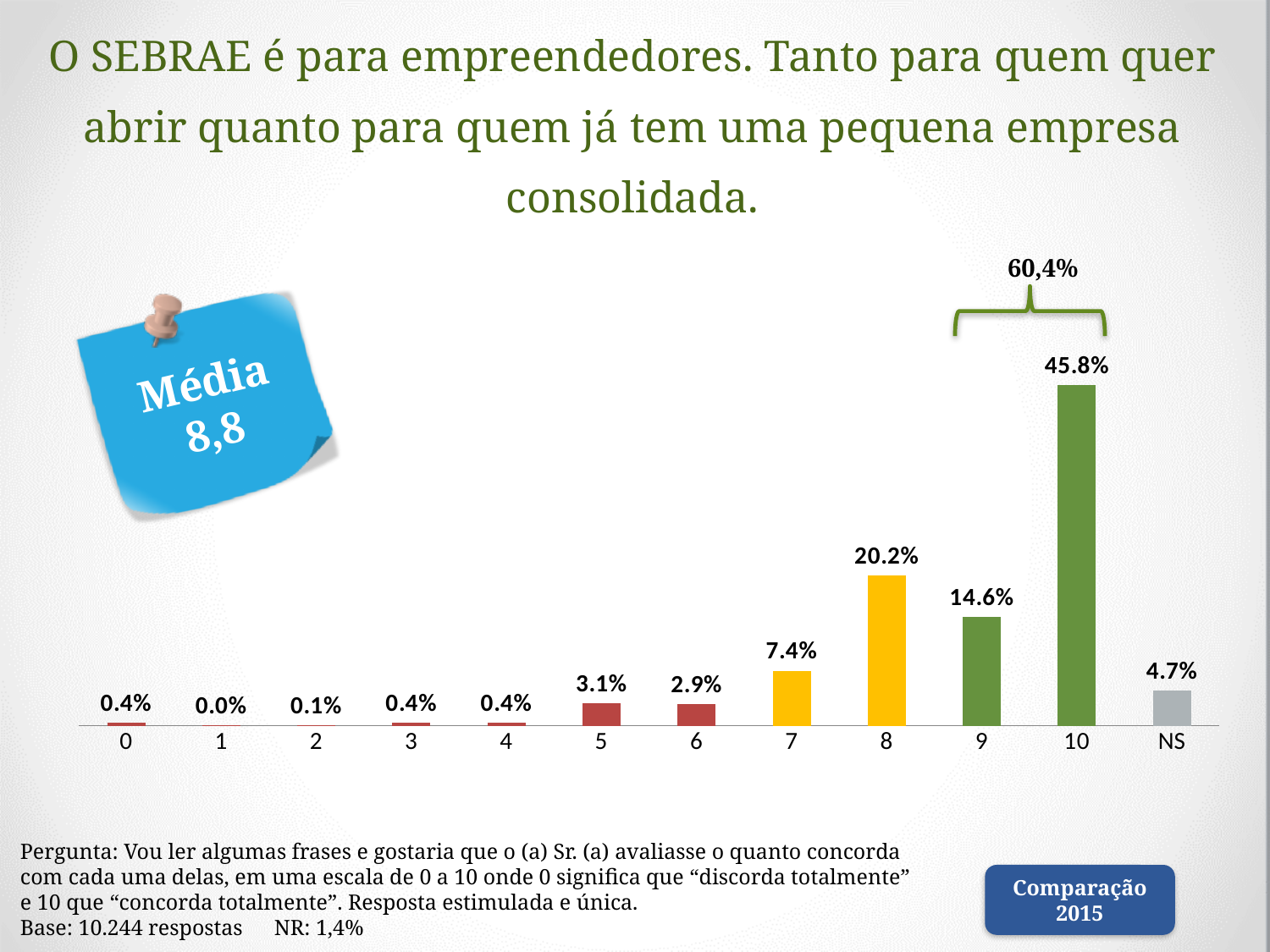
How many categories are shown on the x axis of the chart? 12 What average (Média) is shown on the note in the chart? 8,8 What is the value shown for the NS category? 4.7% Which score category has the lowest percentage? 1 Which is larger, the percentage for score 8 or for score 9? 8 Which score category has the highest percentage? 10 What kind of chart is shown on the slide? bar chart What percentage of respondents gave a score of 10? 45.8% What combined percentage is shown by the bracket above scores 9 and 10? 60,4% What is the difference between the percentages for scores 10 and 9? 31.2% What percentage of respondents gave a score of 8? 20.2% What is the value shown for a score of 5? 3.1%